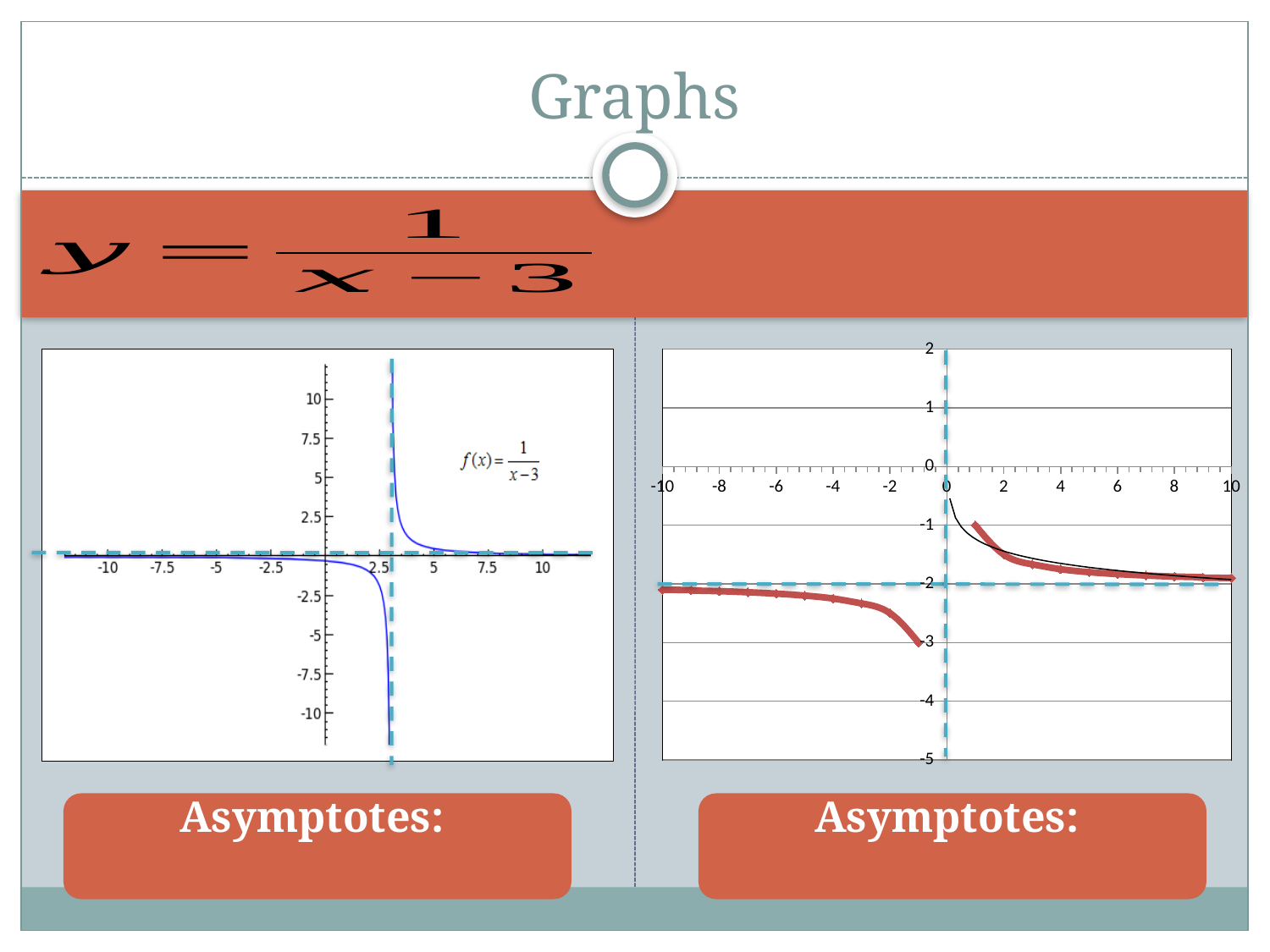
On the left chart, is the value of the curve at x = 5 greater or less than 2.5? less What colour are the dashed asymptote lines drawn on the charts? light blue On the left chart, do the values of the curve rise or fall as x increases from 5 to 10? fall On the right chart, is the value of the red curve at x = -10 greater or less than -3? greater What function is labelled on the left chart? f(x) = 1/(x-3) On the right chart, is the value of the red curve at x = -2 greater or less than -2? less What type of chart is the chart on the right side of the slide? line chart On the right chart, do the values of the red curve rise or fall as x increases from -10 to -2? fall On the right chart, do the values of the red curve rise or fall as x increases from 2 to 10? fall